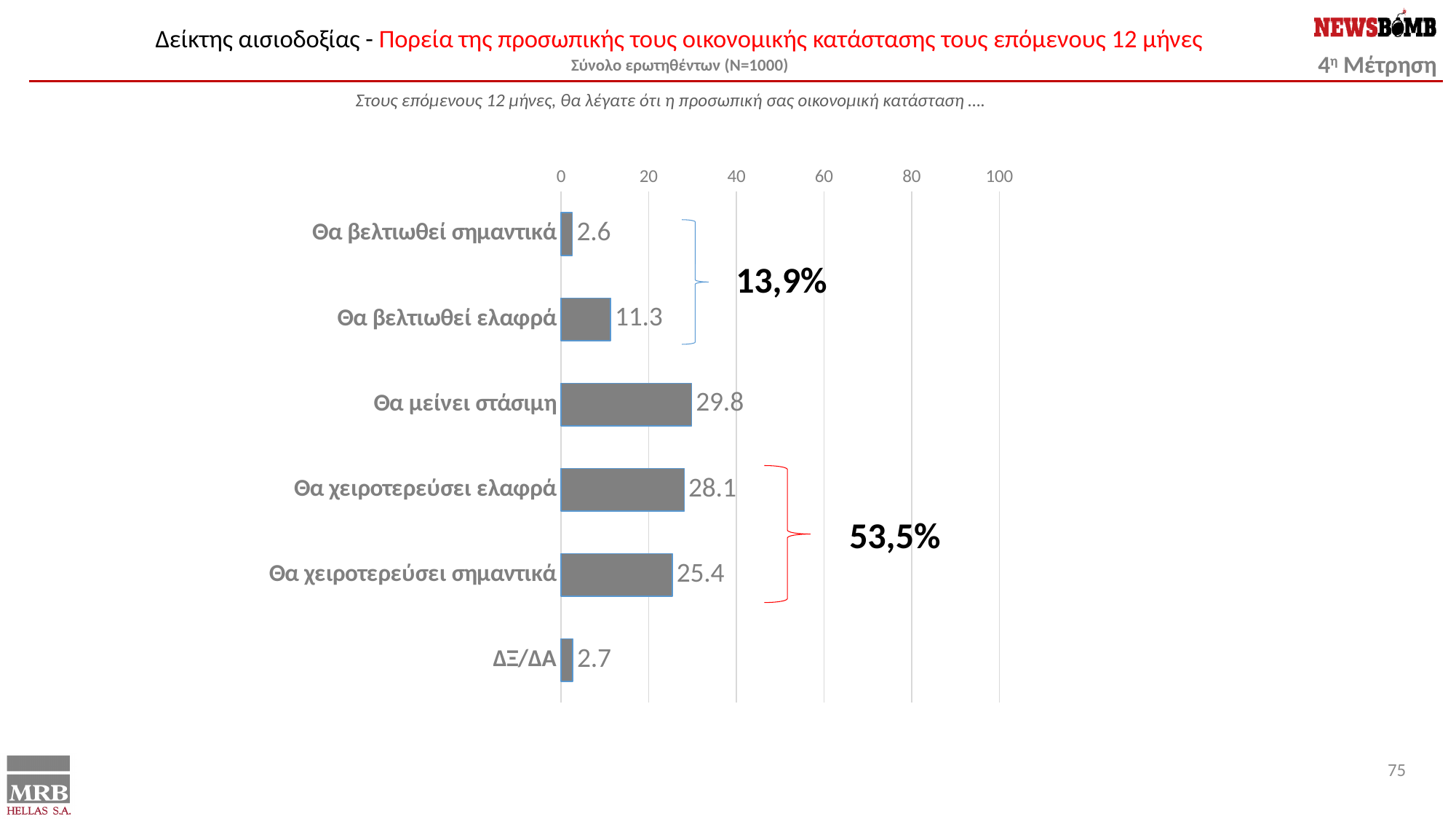
What is the difference between 'Θα χειροτερεύσει ελαφρά' and 'Θα χειροτερεύσει σημαντικά'? 2.7 What is the value for 'Θα μείνει στάσιμη'? 29.8 What combined percentage is shown next to the red bracket grouping the two 'Θα χειροτερεύσει' categories? 53,5% Is the value for 'Θα μείνει στάσιμη' greater or less than 40? less What kind of chart is shown on the slide? bar chart Which category has the lowest value? Θα βελτιωθεί σημαντικά What is the value for 'Θα βελτιωθεί ελαφρά'? 11.3 Which category has the highest value? Θα μείνει στάσιμη How many categories are shown in the chart? 6 What is the value for 'ΔΞ/ΔΑ'? 2.7 Which is larger: 'Θα βελτιωθεί ελαφρά' or 'Θα χειροτερεύσει ελαφρά'? Θα χειροτερεύσει ελαφρά What is the value for 'Θα χειροτερεύσει σημαντικά'? 25.4